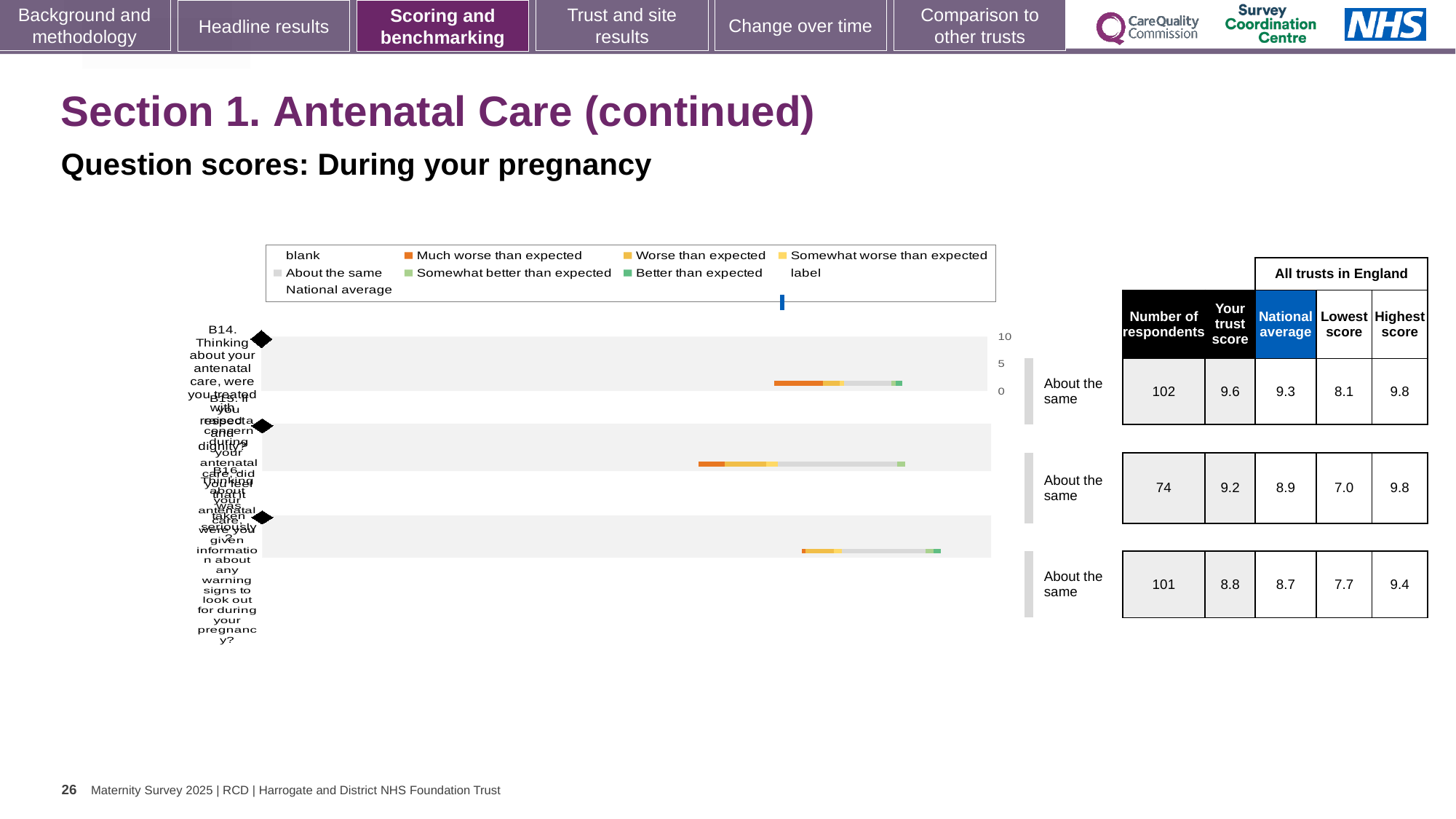
Which row in the table beside the chart has the highest trust score? The first row (B14), 9.6 What benchmark category is shown next to each of the three bars? About the same For the first row (B14), what is the difference between the trust score and the national average? 0.3 What kind of chart is shown on the slide? Bar chart How many entries does the chart legend list? 9 In the table beside the chart, what is the national average for the third row (B16)? 8.7 In the table beside the chart, what is the number of respondents for the first row (B14)? 102 Which row in the table beside the chart has the lowest 'Lowest score' value? The second row (B15), 7.0 In the table beside the chart, what is the trust score for the second row (B15)? 9.2 For the second row (B15), which is larger: the trust score or the national average? The trust score (9.2) What is the highest tick value shown on the chart's axis? 10 How many question rows (bars) are plotted in the chart? 3